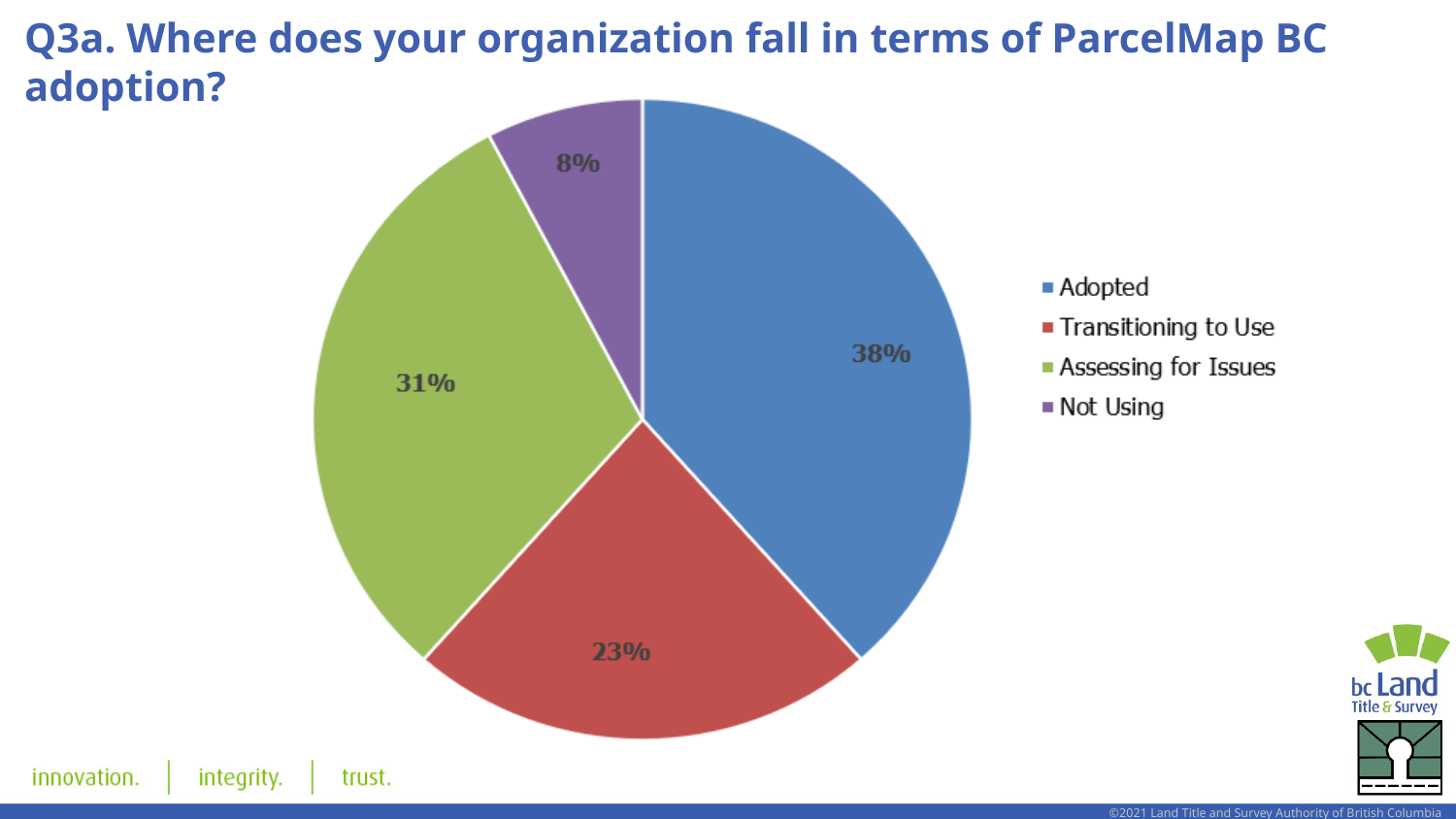
Which category has the smallest share of the pie? Not Using What percentage of organizations are Assessing for Issues? 31% What type of chart is shown on the slide? pie chart What percentage of organizations are Not Using ParcelMap BC? 8% What percentage of organizations have Adopted ParcelMap BC? 38% What colour is the slice for Transitioning to Use? red What is the combined share of Adopted and Transitioning to Use? 61% What is the difference in percentage points between Adopted and Not Using? 30 What percentage of organizations are Transitioning to Use? 23% Which is larger, the share for Assessing for Issues or the share for Transitioning to Use? Assessing for Issues Which category has the largest share of the pie? Adopted How many categories does the pie chart have? 4